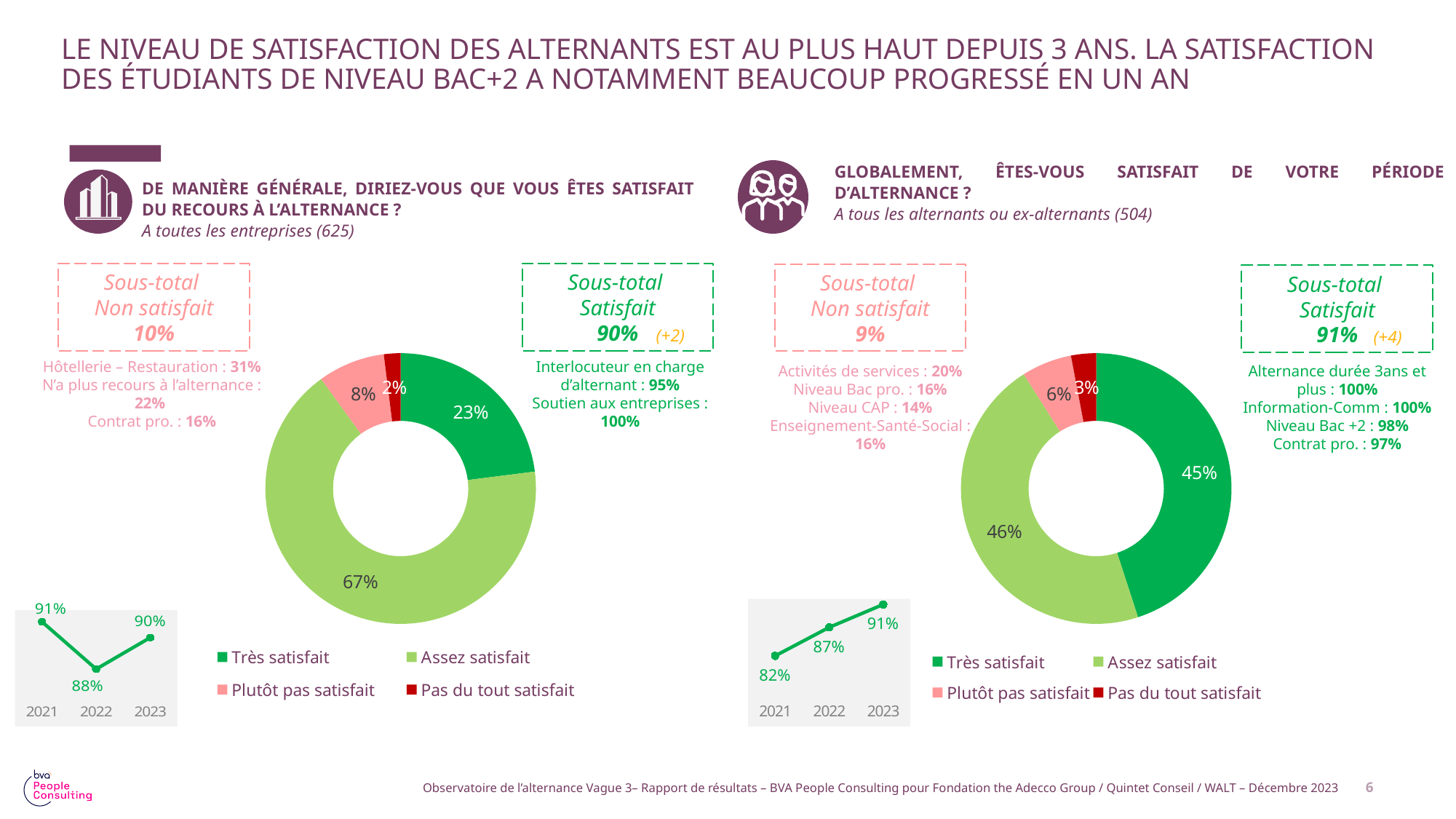
In the left donut chart (entreprises), which category has the largest share? Assez satisfait In the right donut chart (alternants), which category has the smallest share? Pas du tout satisfait In the right donut chart (alternants), which is larger: 'Plutôt pas satisfait' or 'Pas du tout satisfait'? Plutôt pas satisfait In the small line chart at the bottom right (alternants), do the values rise or fall from 2021 to 2023? Rise In the left donut chart (entreprises), what is the difference between 'Assez satisfait' and 'Très satisfait'? 44 percentage points How many categories does the legend of the left donut chart (entreprises) list? 4 In the left donut chart (entreprises), what share is 'Très satisfait'? 23% In the left donut chart (entreprises), what share is 'Assez satisfait'? 67% In the right donut chart (alternants), what share is 'Pas du tout satisfait'? 3% In the small line chart at the bottom left (entreprises), what is the value for 2022? 88% What type of chart is used to show the satisfaction breakdown for entreprises on the left? Donut (pie) chart In the right donut chart (alternants), what share is 'Très satisfait'? 45%